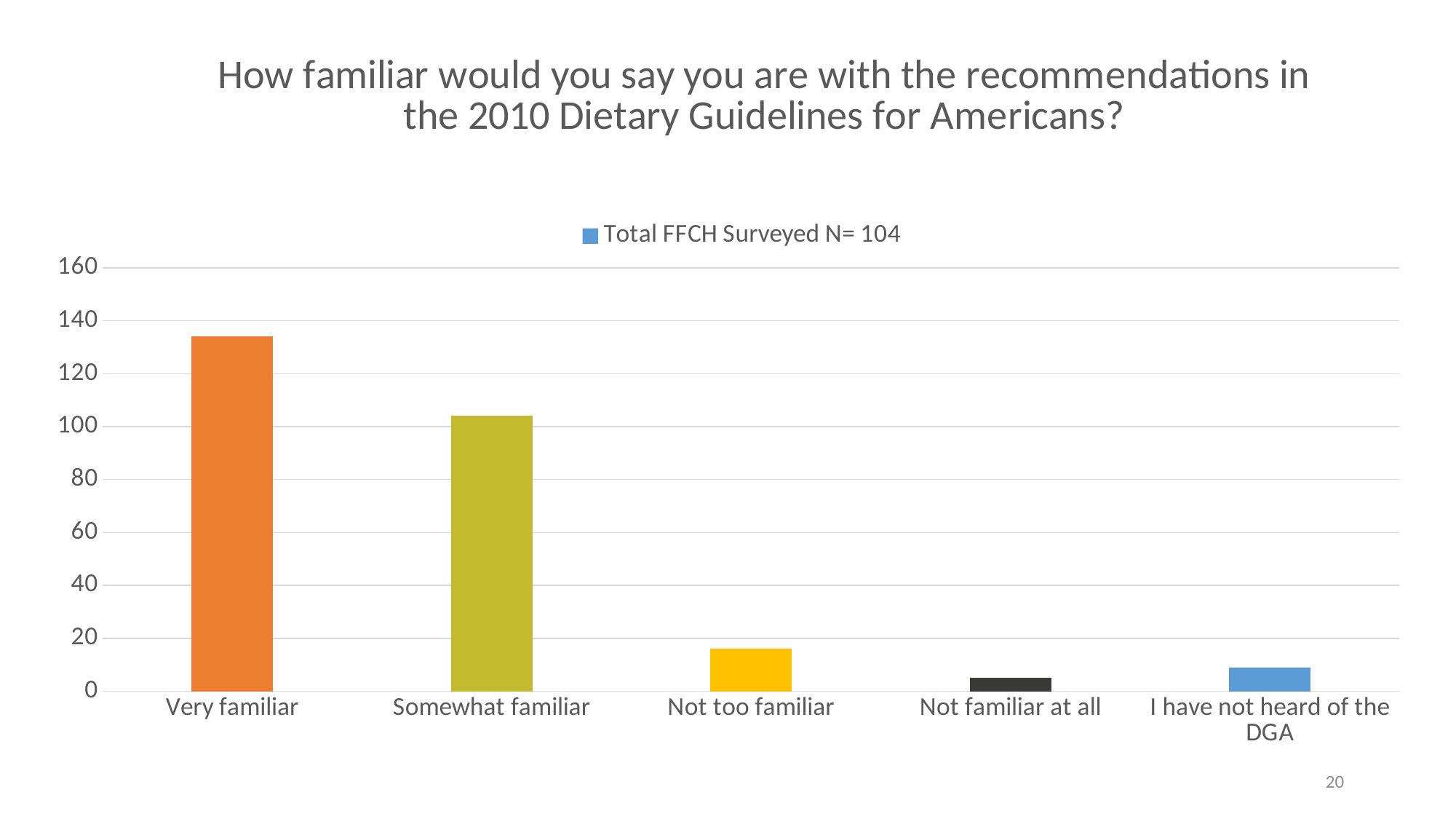
Is the value for Not too familiar greater or less than 40? less Which is larger, the value for Not too familiar or the value for I have not heard of the DGA? Not too familiar Is the value for Very familiar greater or less than 120? greater Is the value for Very familiar greater or less than 140? less Which category has the lowest value? Not familiar at all Which category has the highest value? Very familiar What is the legend entry for the series shown? Total FFCH Surveyed N= 104 How many categories are shown on the x axis? 5 Which is larger, the value for Somewhat familiar or the value for Not too familiar? Somewhat familiar What kind of chart is shown on the slide? bar chart How many series does the legend list? 1